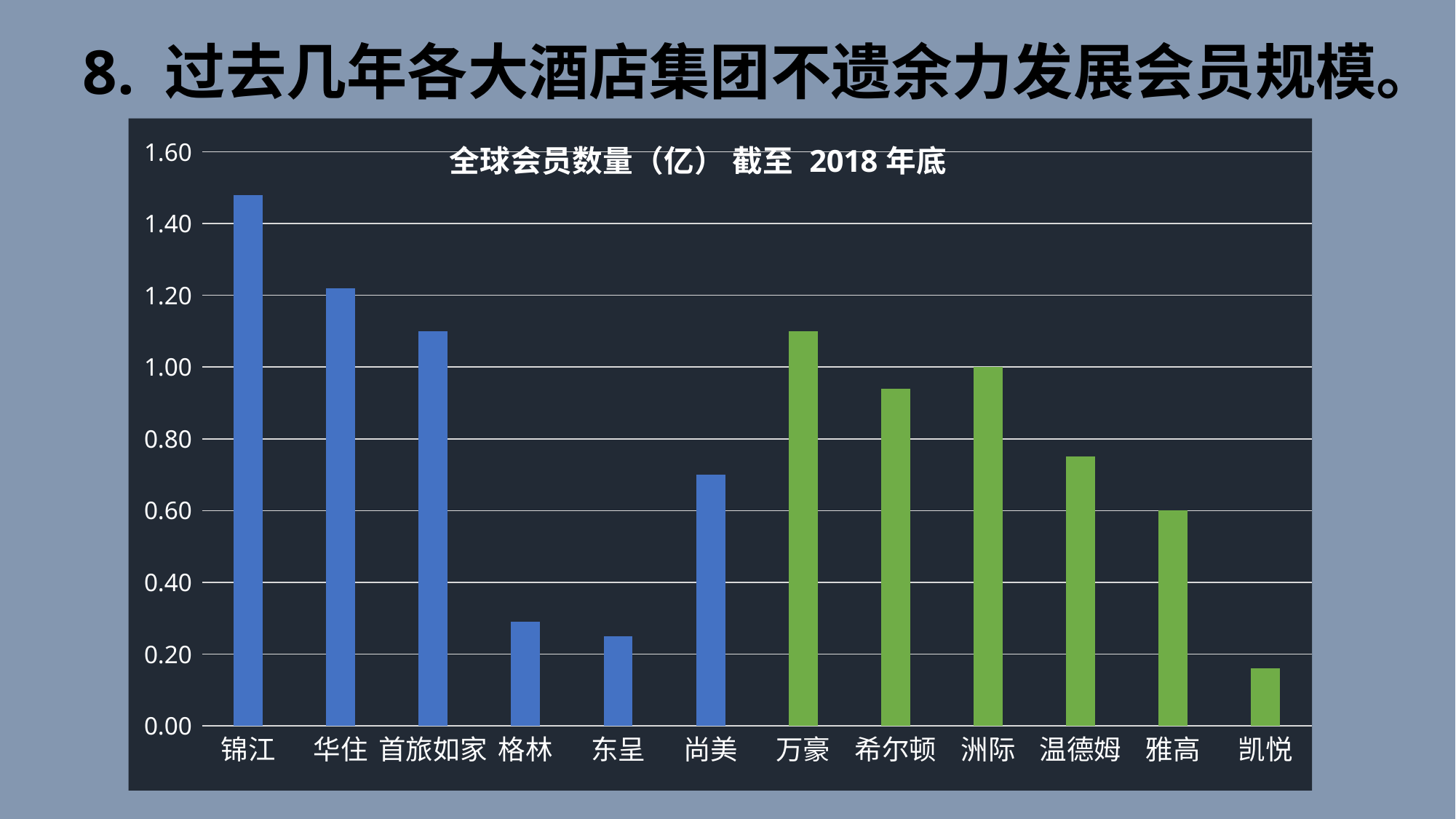
Is the value for 希尔顿 greater or less than 0.80? greater What is the value for 雅高 in the chart? 0.60 Is the value for 东呈 greater or less than 0.40? less What kind of chart is shown on the slide? bar chart Which has a larger value, 华住 or 万豪? 华住 What is the title of the chart? 全球会员数量（亿） 截至 2018 年底 Which hotel group has the lowest global member count in the chart? 凯悦 How many hotel groups are shown on the x axis of the chart? 12 Which has a larger value, 温德姆 or 尚美? 温德姆 What is the value for 洲际 in the chart? 1.00 Which hotel group has the highest global member count in the chart? 锦江 Is the value for 锦江 greater or less than 1.40? greater